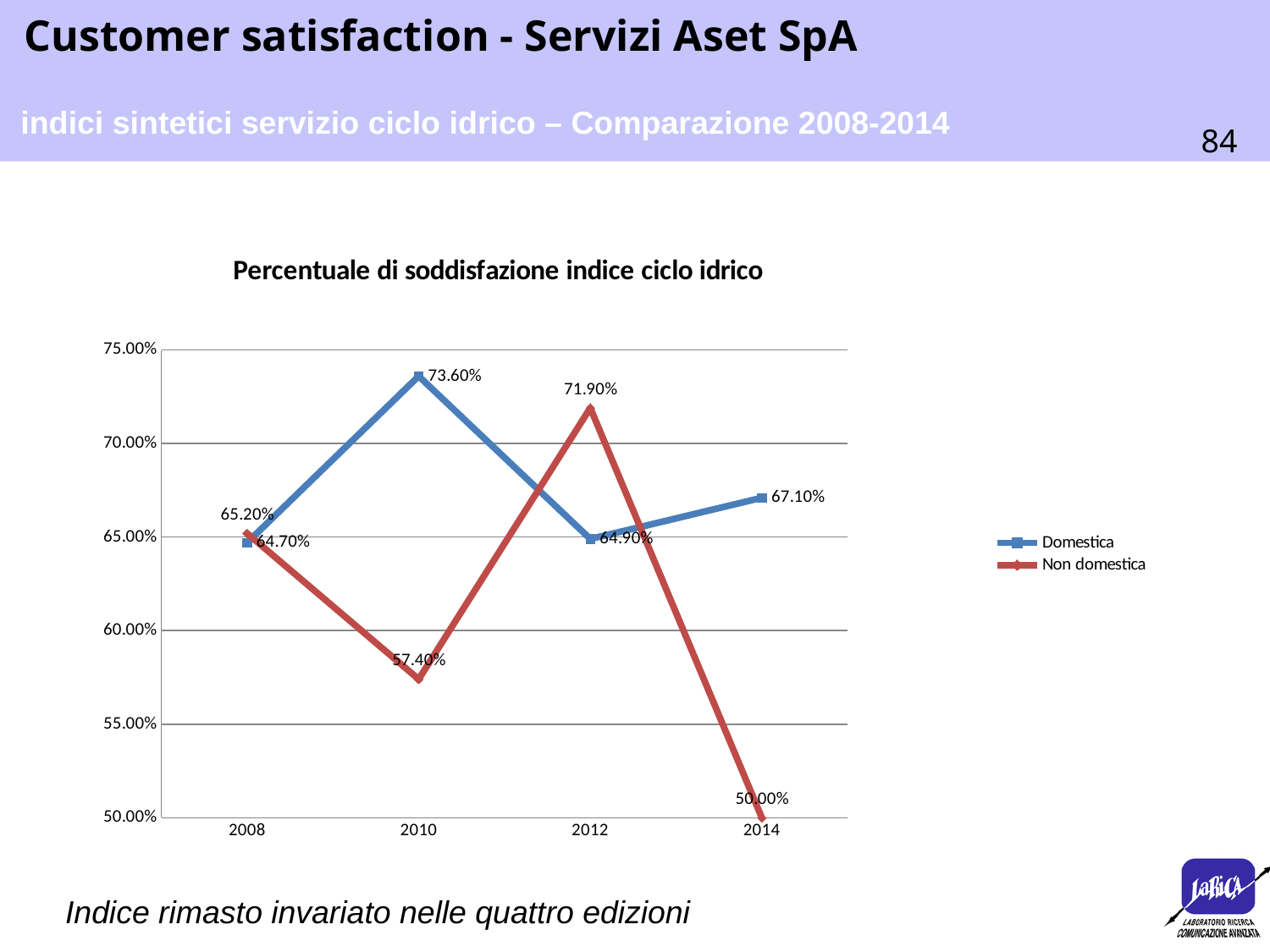
What is the value for Domestica in 2010? 73.60% What type of chart is shown on the slide? line chart What is the title of the chart? Percentuale di soddisfazione indice ciclo idrico In which year is the Domestica series highest? 2010 Does the Non domestica series rise or fall from 2012 to 2014? fall How many years are plotted on the x axis? 4 What is the value for Non domestica in 2014? 50.00% Which series has the larger value in 2012, Domestica or Non domestica? Non domestica In which year is the Non domestica series lowest? 2014 What is the difference between Domestica and Non domestica in 2014? 17.10% How many series does the legend list? 2 What is the value for Non domestica in 2012? 71.90%